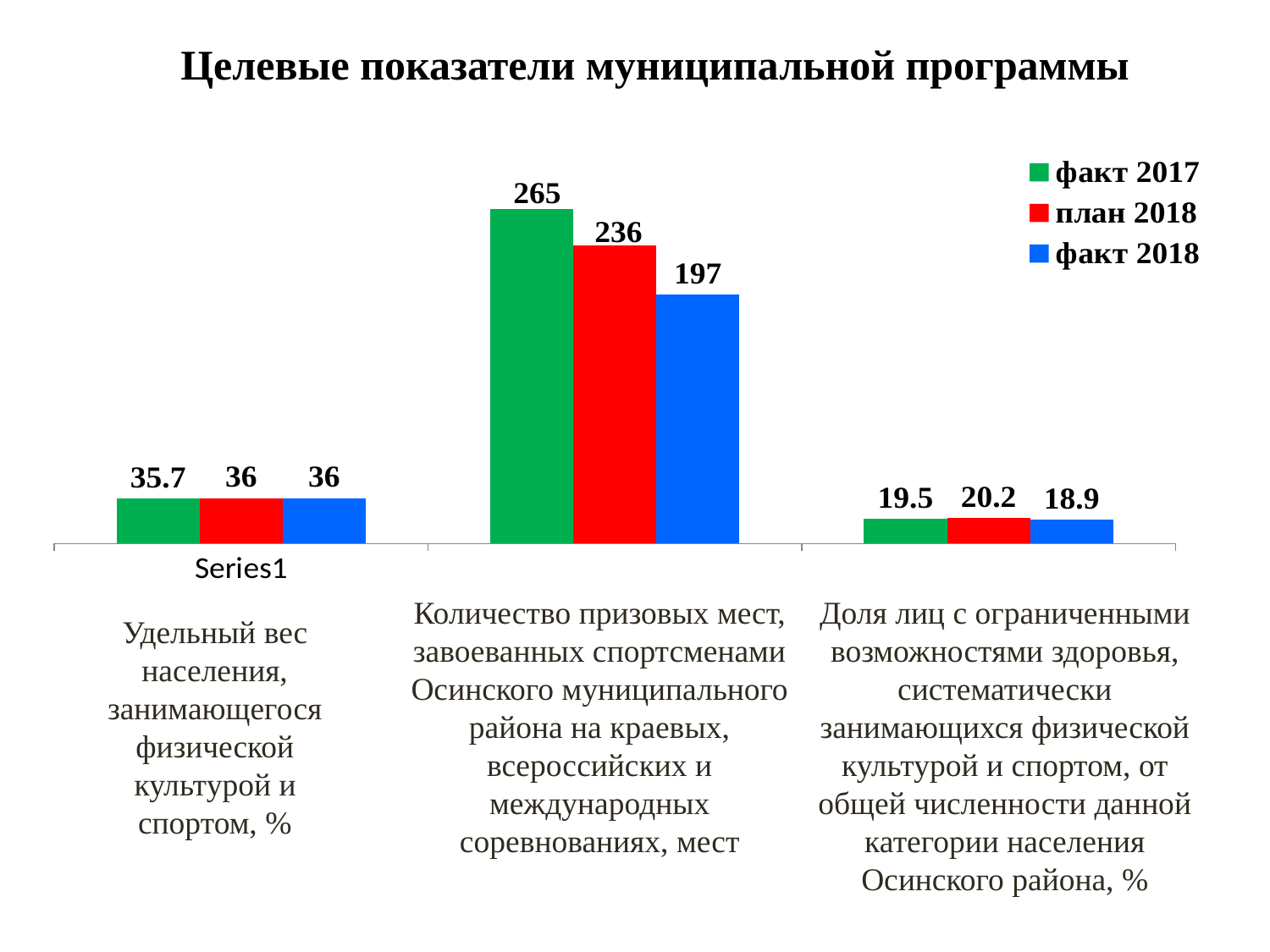
What is the план 2018 value for 'Удельный вес населения, занимающегося физической культурой и спортом, %'? 36 What type of chart is shown on the slide? bar chart What is the difference between the факт 2017 and план 2018 values for 'Удельный вес населения, занимающегося физической культурой и спортом, %'? 0.3 What is the difference between the план 2018 and факт 2018 values for 'Количество призовых мест...'? 39 What is the title of the chart? Целевые показатели муниципальной программы How many series does the legend list? 3 What is the факт 2017 value for 'Доля лиц с ограниченными возможностями здоровья, систематически занимающихся физической культурой и спортом...'? 19.5 What is the факт 2017 value for 'Количество призовых мест, завоеванных спортсменами Осинского муниципального района...'? 265 Which series has the lowest value for 'Доля лиц с ограниченными возможностями здоровья...'? факт 2018 For 'Доля лиц с ограниченными возможностями здоровья...', which is larger: план 2018 or факт 2018? план 2018 What is the факт 2018 value for 'Количество призовых мест, завоеванных спортсменами Осинского муниципального района...'? 197 Which series has the highest value for 'Количество призовых мест...'? факт 2017